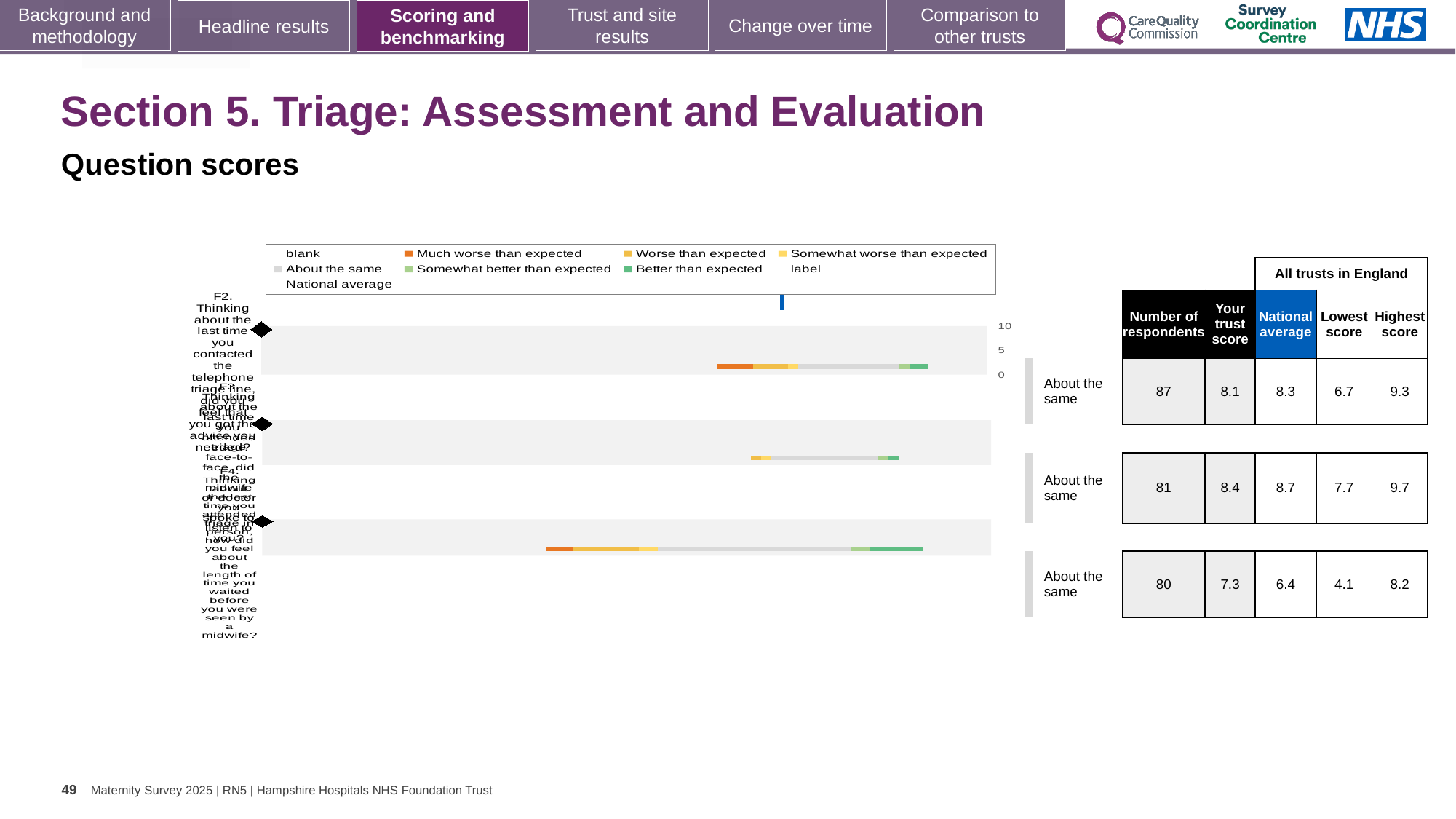
What is the national average for the third question? 6.4 For the second question, how much higher is the national average than the trust score? 0.3 How many questions (rows) are shown in the chart and table? 3 What benchmark category is shown for all three questions? About the same Which question has the highest trust score? the second question (8.4) What is the number of respondents for the first question (F2)? 87 What is the trust score for the first question (F2)? 8.1 Which question has the lowest 'Lowest score' value? the third question (4.1) What kind of chart is shown on the slide? bar chart For the third question, which is larger: the trust score or the national average? the trust score (7.3) For the third question, what is the difference between the highest score and the lowest score? 4.1 What is the highest score among all trusts in England for the second question? 9.7